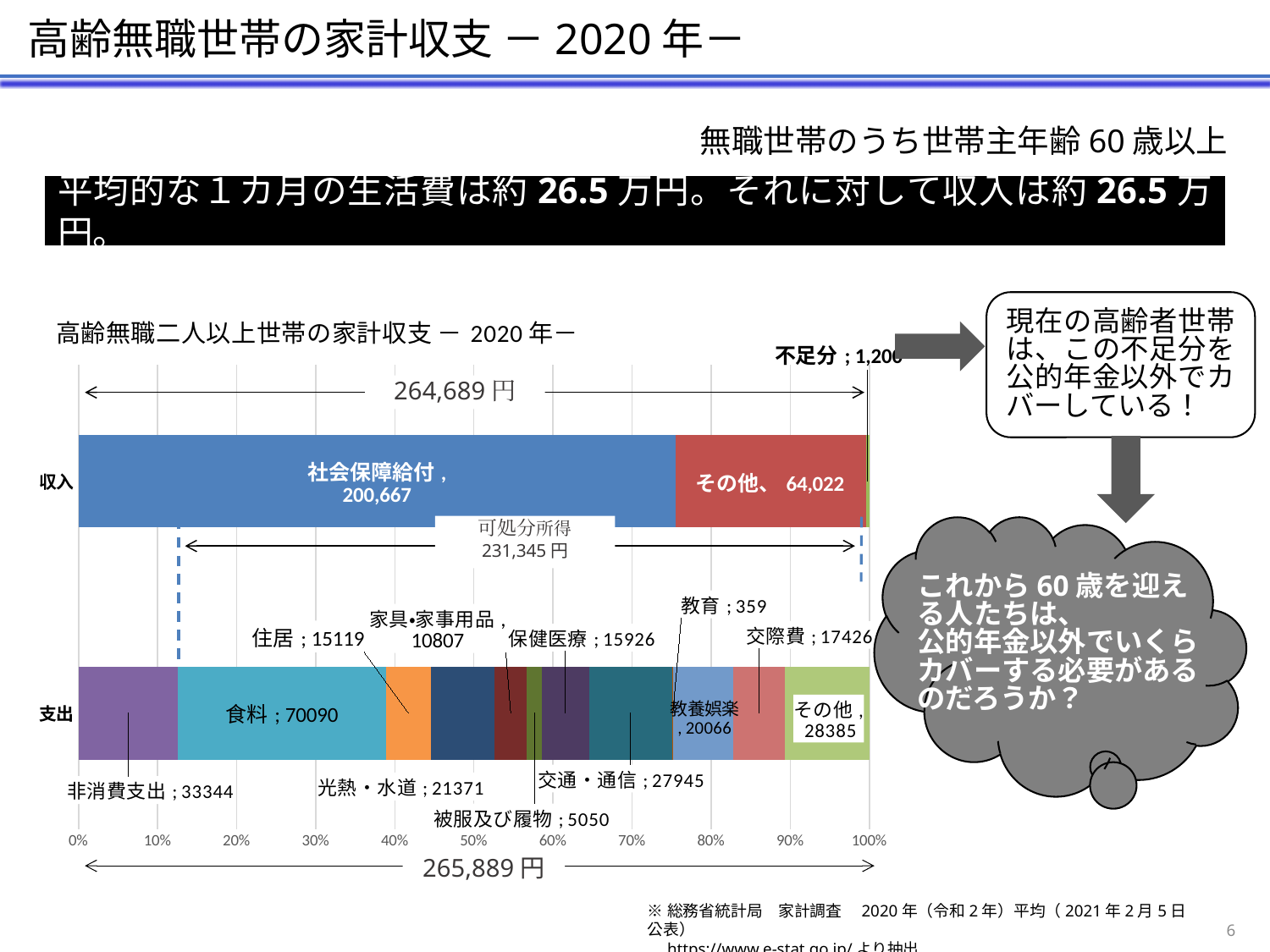
Which category in the 支出 bar has the smallest value? 教育 What is the 可処分所得 amount shown on the chart? 231,345円 In the 支出 bar, what is the value for 食料? 70090 How many categories make up the 支出 bar? 12 In the 支出 bar, what is the value for 教育? 359 In the 収入 bar, what is the value for 社会保障給付? 200,667 What is the value labelled 不足分 on the chart? 1,200 In the 収入 bar, what is the difference between 社会保障給付 and その他? 136,645 What kind of chart is shown on the slide? Stacked bar chart In the 支出 bar, which is larger: 交通・通信 or 光熱・水道? 交通・通信 What is the total of the 支出 bar as printed on the chart? 265,889円 Which category in the 支出 bar has the largest value? 食料